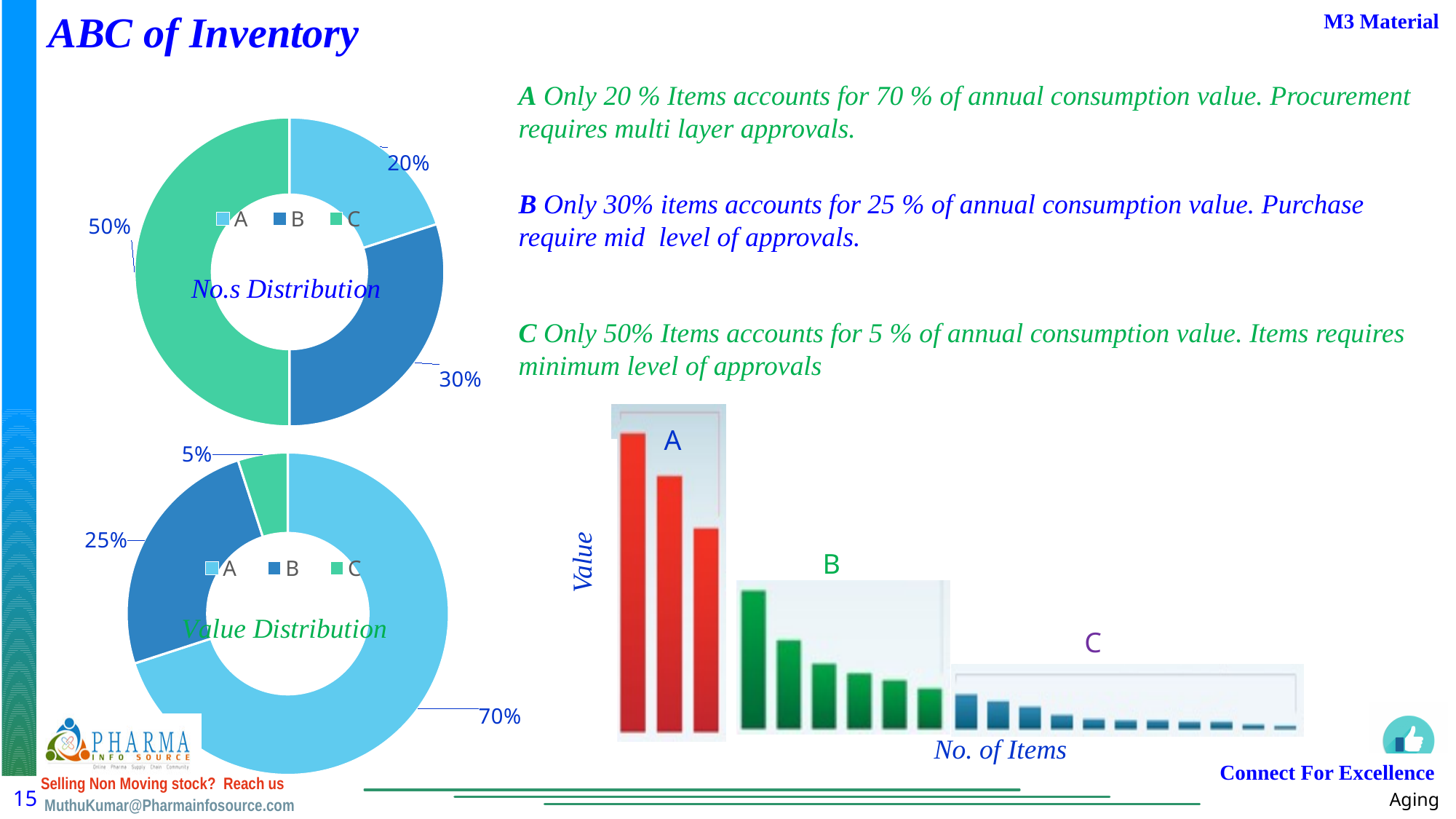
How many entries does the legend of the No.s Distribution chart list? 3 In the No.s Distribution chart, which is larger, the value for B or the value for A? B What kind of chart is the Value Distribution chart? Doughnut chart In the Value Distribution chart, what is the difference between the values for A and B? 45% In the Value Distribution chart, what is the value for C? 5% How many categories does the Value Distribution chart show? 3 In the bar chart at the bottom right, what is the label on the vertical axis? Value In the No.s Distribution chart, what is the value for A? 20% In the Value Distribution chart, what is the value for A? 70% In the Value Distribution chart, which category has the smallest share? C In the No.s Distribution chart, which category has the largest share? C In the No.s Distribution chart, what is the value for C? 50%